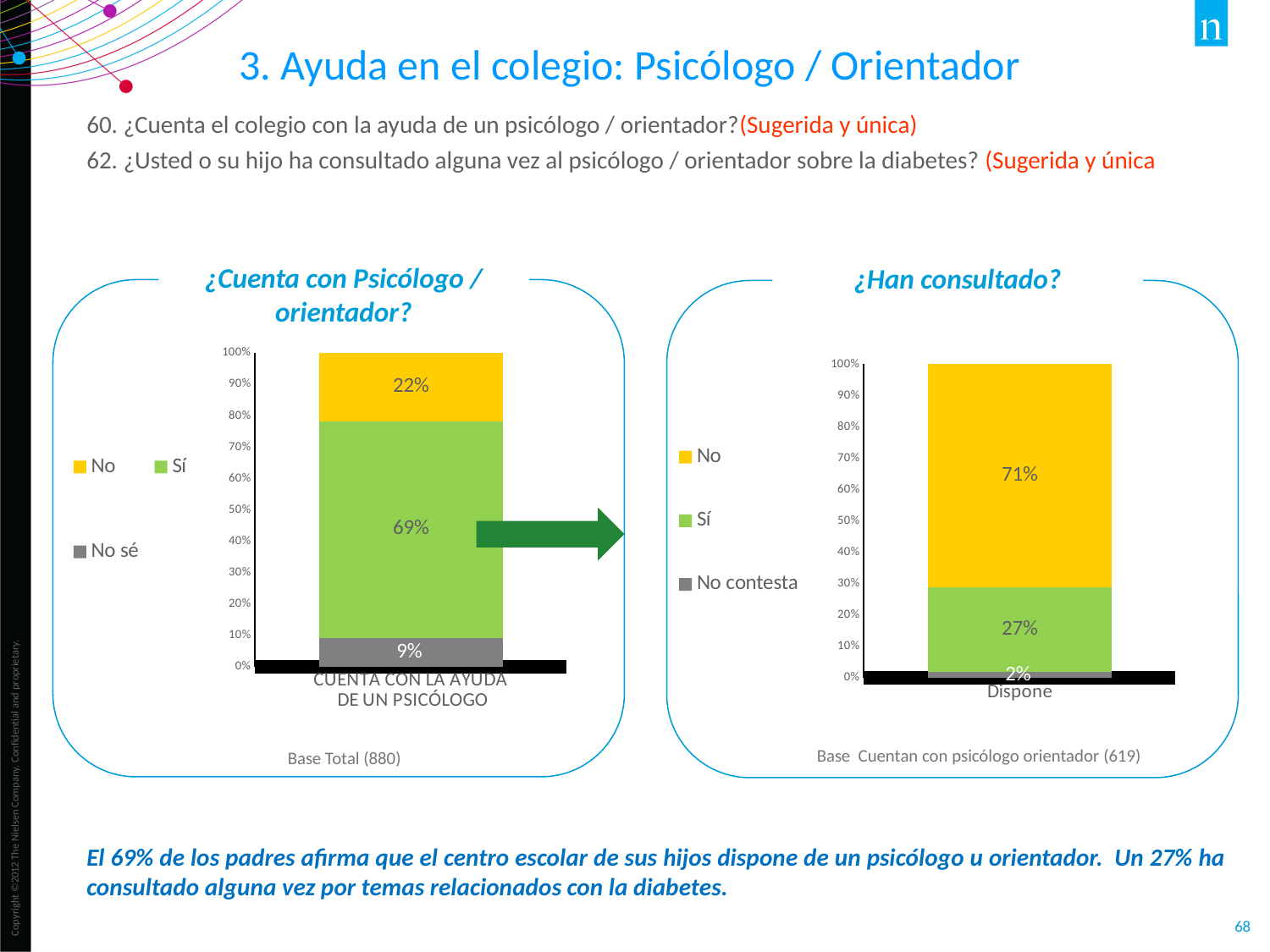
In the '¿Cuenta con Psicólogo / orientador?' chart, what percentage is shown for 'No sé'? 9% In the '¿Cuenta con Psicólogo / orientador?' chart, which response has the largest share? Sí How many series does the legend of the '¿Han consultado?' chart list? 3 In the '¿Cuenta con Psicólogo / orientador?' chart, which is larger, 'No' or 'No sé'? No What type of chart is the '¿Cuenta con Psicólogo / orientador?' chart? Stacked bar chart In the '¿Han consultado?' chart, what is the difference between the 'No' and 'Sí' percentages? 44% In the '¿Han consultado?' chart, what percentage is shown for 'No'? 71% In the '¿Cuenta con Psicólogo / orientador?' chart, what percentage is shown for 'Sí'? 69% In the '¿Han consultado?' chart, which response has the smallest share? No contesta In the '¿Han consultado?' chart, what percentage is shown for 'Sí'? 27% In the '¿Han consultado?' chart, what percentage is shown for 'No contesta'? 2% In the '¿Cuenta con Psicólogo / orientador?' chart, what percentage is shown for 'No'? 22%